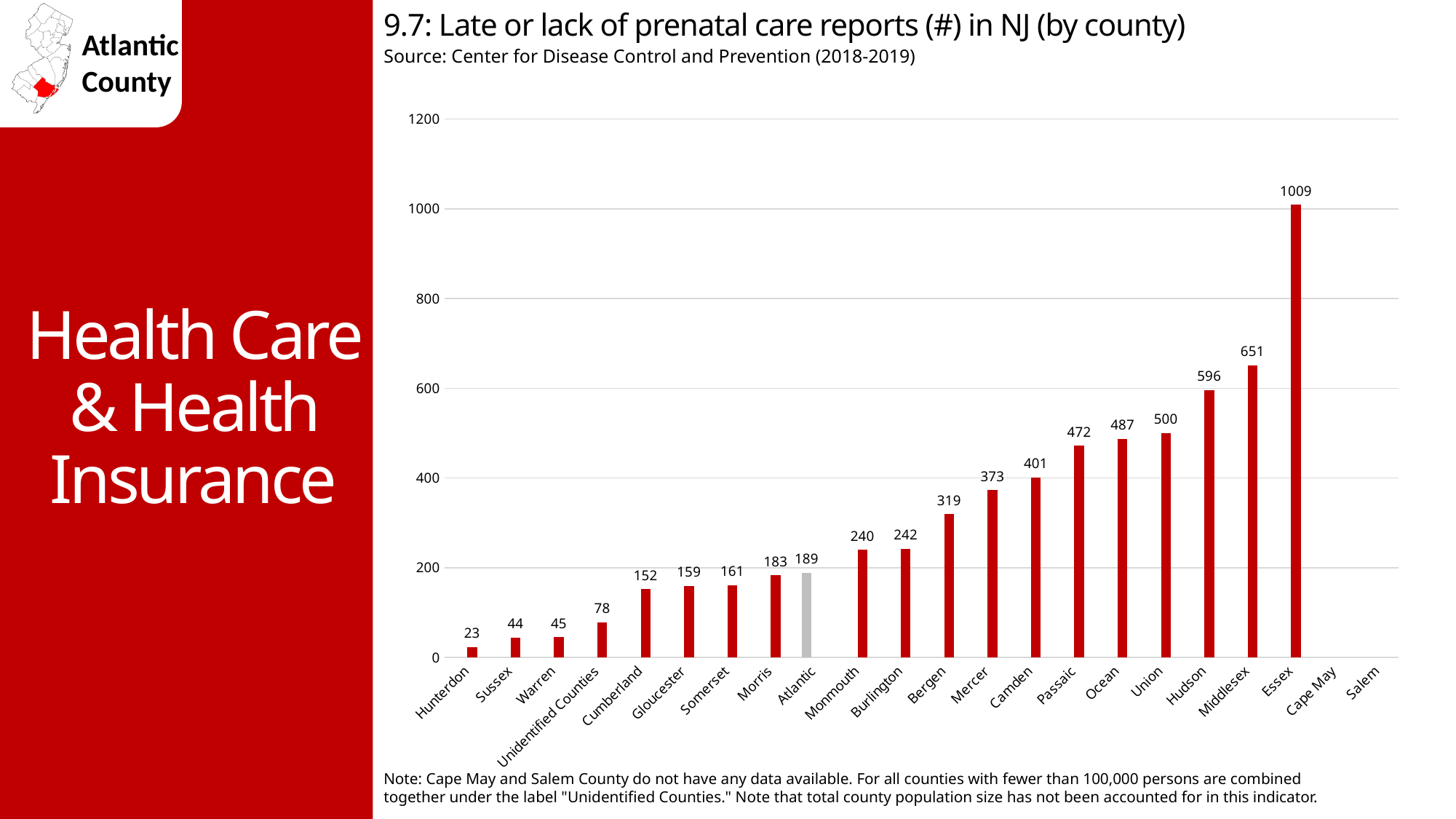
Which has a larger value, Passaic or Ocean? Ocean What type of chart is shown on the slide? bar chart What is the value shown for Unidentified Counties? 78 Is the value for Bergen greater or less than 400? less Which county with a plotted bar has the lowest number of reports? Hunterdon Do the values generally rise or fall moving from left to right along the x axis? rise What is the value shown for Essex County? 1009 What is the number of late or lack of prenatal care reports for Atlantic County? 189 Which bar is shown in a different colour (grey) from the others? Atlantic What is the difference between the values for Middlesex and Hudson? 55 How many counties are labeled on the x axis of the chart? 22 Which county has the highest number of late or lack of prenatal care reports? Essex